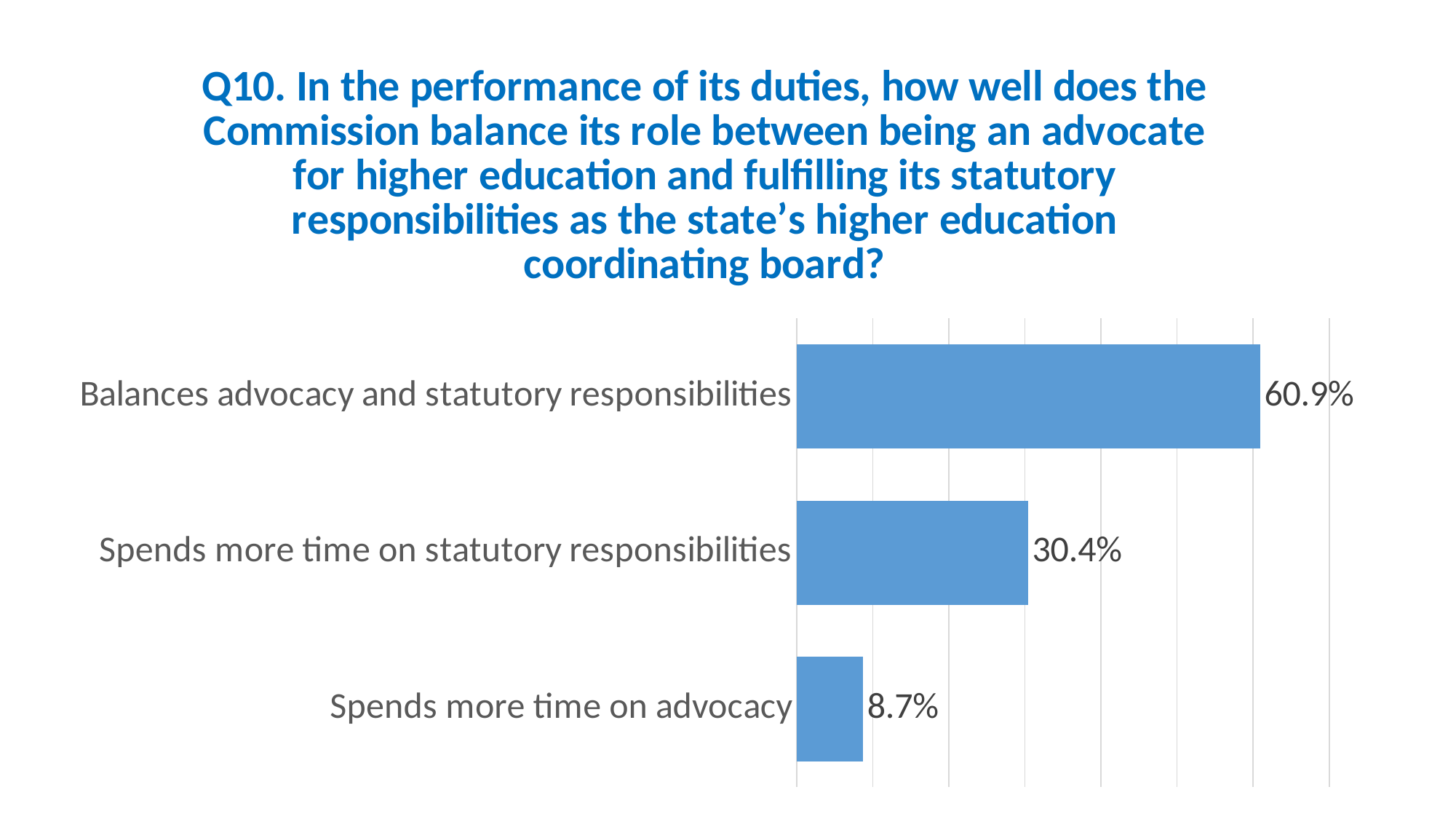
What kind of chart is shown on the slide? Bar chart How many response categories are shown in the chart? 3 Which response category has the highest value? Balances advocacy and statutory responsibilities What is the difference between 'Spends more time on statutory responsibilities' and 'Spends more time on advocacy'? 21.7% What is the difference between 'Balances advocacy and statutory responsibilities' and 'Spends more time on statutory responsibilities'? 30.5% Which response category has the lowest value? Spends more time on advocacy What is the value for 'Spends more time on advocacy'? 8.7% What question number is referenced in the chart title? Q10 Which is larger: 'Spends more time on statutory responsibilities' or 'Spends more time on advocacy'? Spends more time on statutory responsibilities What is the total of the three percentages shown in the chart? 100% What percentage of respondents said the Commission balances advocacy and statutory responsibilities? 60.9% What is the value for 'Spends more time on statutory responsibilities'? 30.4%